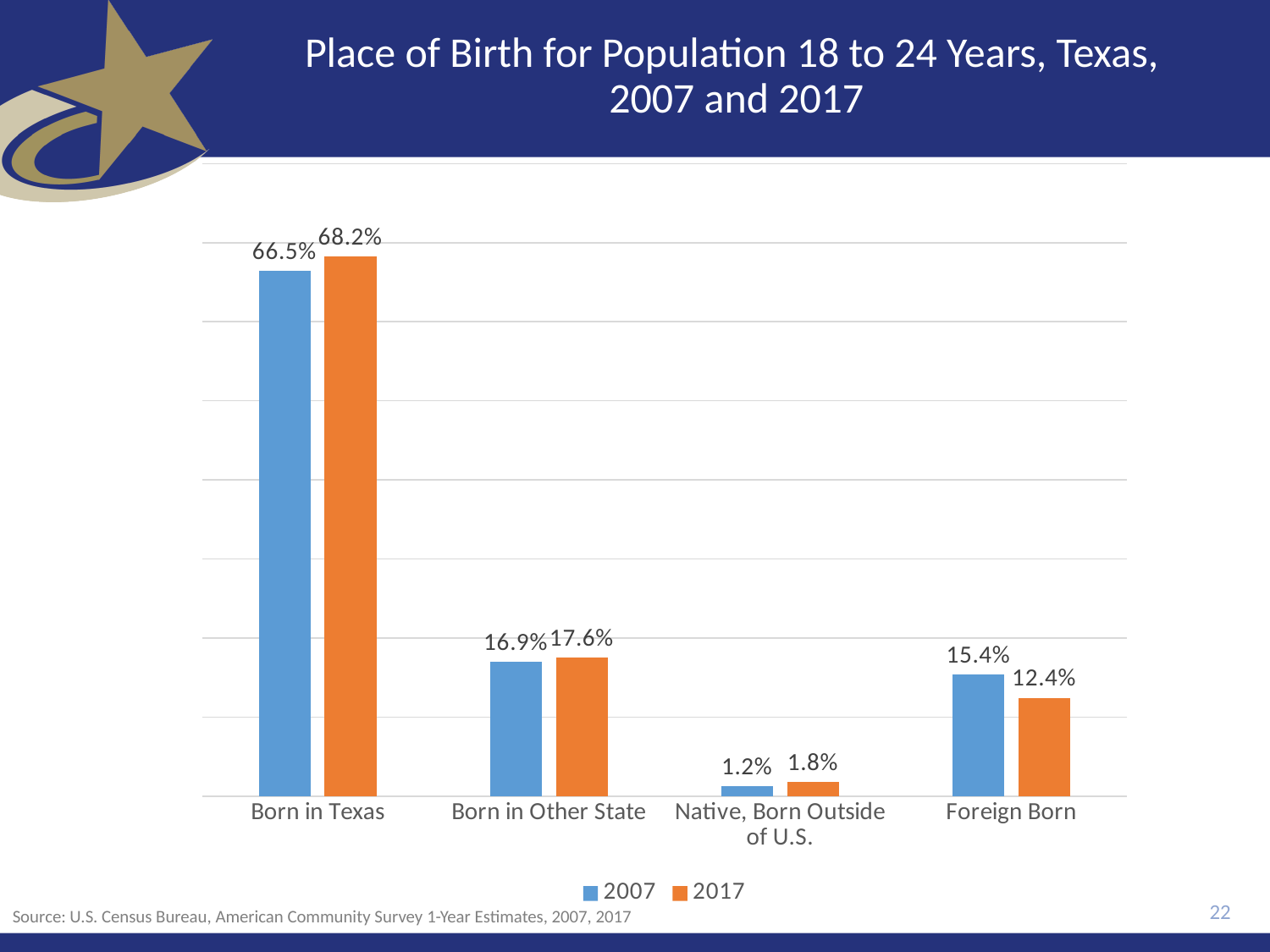
What was the Foreign Born percentage in 2017? 12.4% How many series does the legend list? 2 By how many percentage points did the Foreign Born share change from 2007 to 2017? 3.0 percentage points lower (15.4% to 12.4%) What was the percentage of the Texas population aged 18 to 24 born in Texas in 2017? 68.2% What was the percentage of the Texas population aged 18 to 24 born in Texas in 2007? 66.5% Was the Foreign Born percentage higher in 2007 or in 2017? 2007 What is the difference between the 2017 and 2007 values for Born in Other State? 0.7 percentage points Which place-of-birth category had the highest percentage in 2017? Born in Texas What was the percentage for Native, Born Outside of U.S. in 2007? 1.2% What type of chart is shown on the slide? Bar chart Which place-of-birth category had the lowest percentage in 2007? Native, Born Outside of U.S. How many place-of-birth categories are shown on the chart? 4